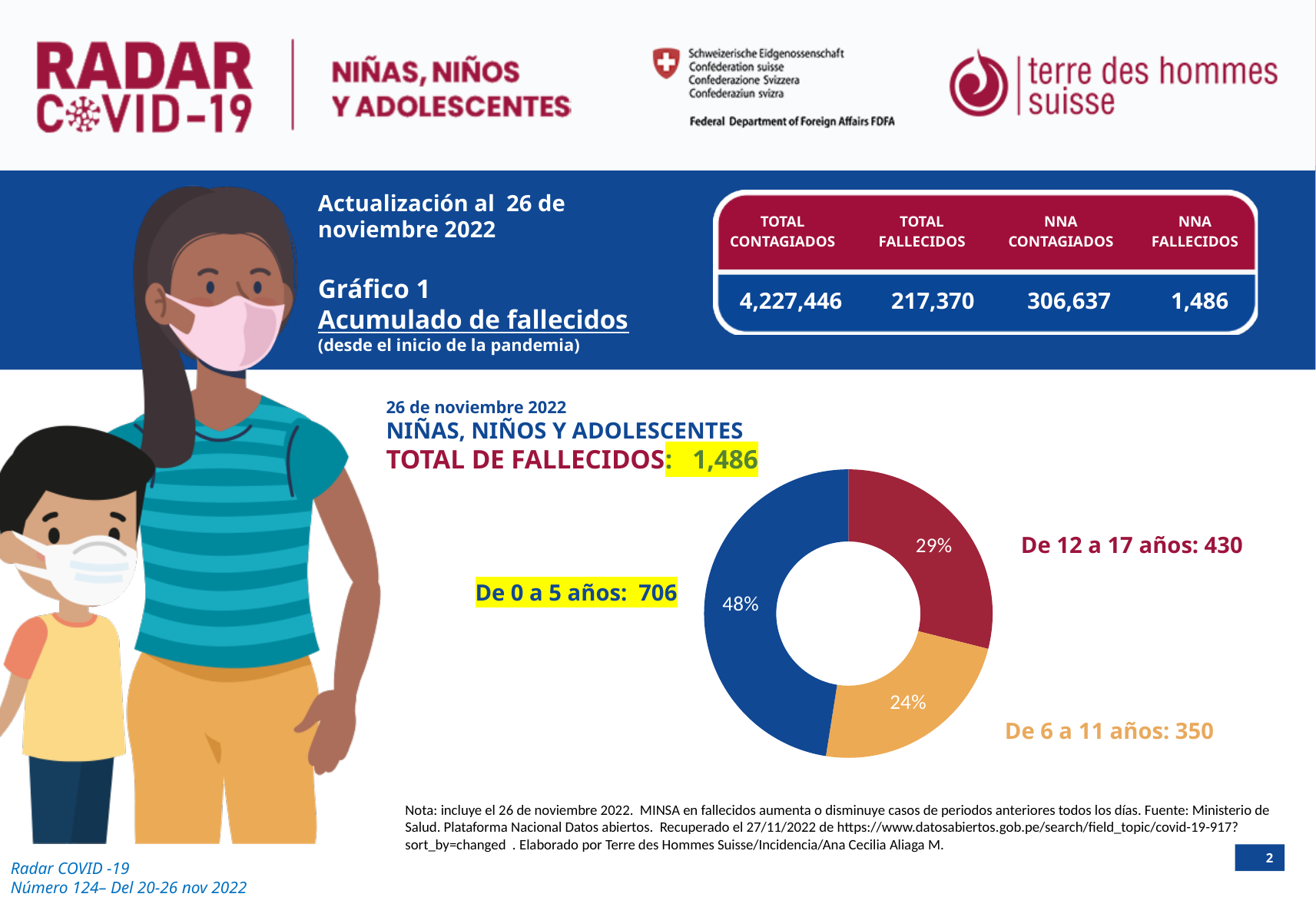
Which age group has the smallest share of deaths? De 6 a 11 años What is the difference in deaths between the 'De 0 a 5 años' group and the 'De 12 a 17 años' group? 276 Which age group has the largest share of deaths? De 0 a 5 años What is the number of deaths for the group 'De 6 a 11 años'? 350 What percentage share of the pie does the 'De 6 a 11 años' group have? 24% What is the total number of deaths shown for niñas, niños y adolescentes? 1,486 What is the number of deaths for the group 'De 0 a 5 años'? 706 What kind of chart is shown on the slide? Pie chart (donut) What percentage share of the pie does the 'De 0 a 5 años' group have? 48% What is the number of deaths for the group 'De 12 a 17 años'? 430 How many age groups does the pie chart show? 3 Which group has more deaths, 'De 6 a 11 años' or 'De 12 a 17 años'? De 12 a 17 años